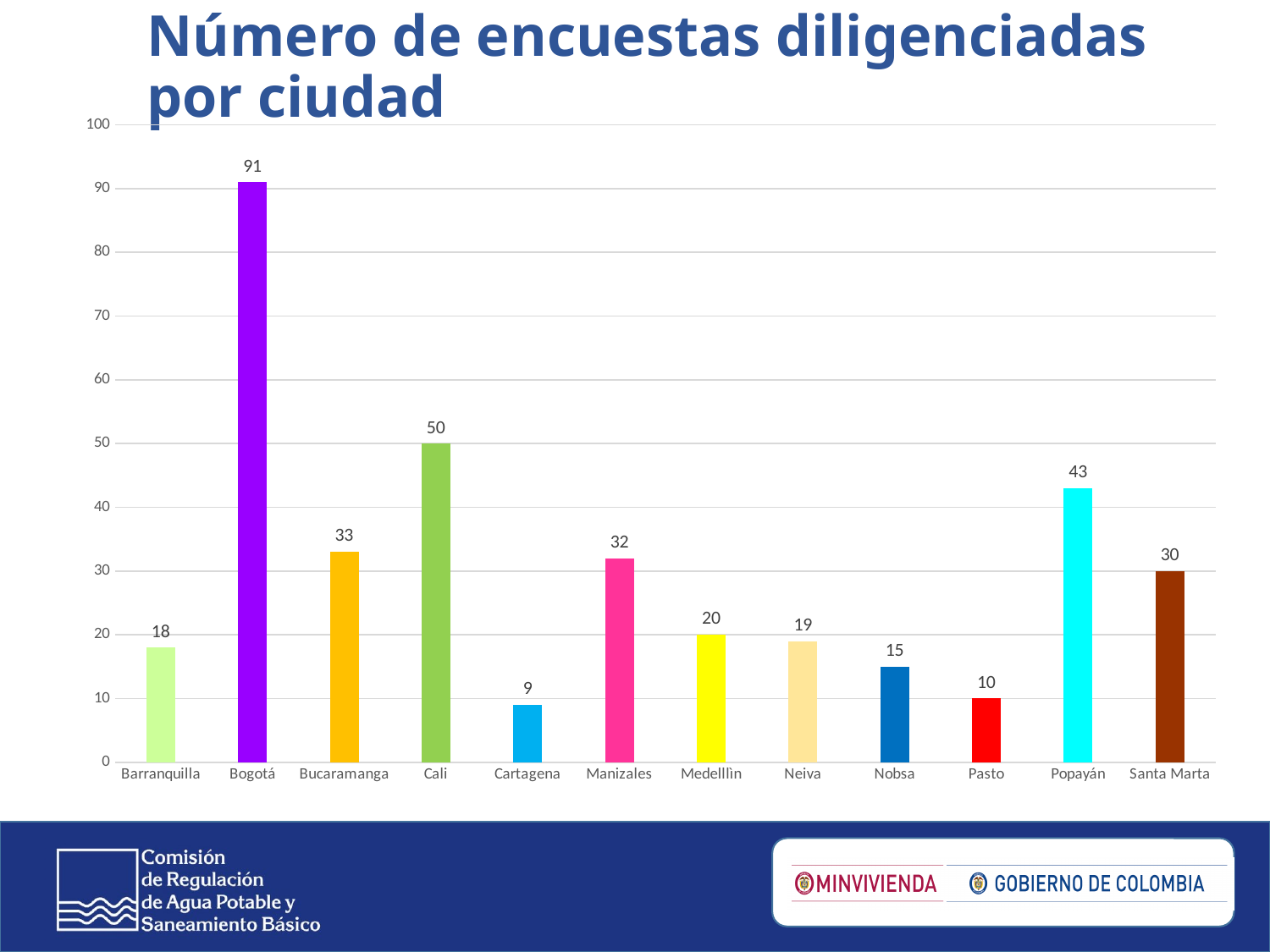
What is the value shown for Medellìn? 20 What is the difference between the values for Bucaramanga and Manizales? 1 Which city has the highest number of surveys? Bogotá How many surveys were completed in Bogotá? 91 Which city has the lowest number of surveys? Cartagena What kind of chart is shown on the slide? Bar chart How many cities are shown on the chart? 12 What is the title of the chart? Número de encuestas diligenciadas por ciudad Which has a larger value, Popayán or Santa Marta? Popayán Which has a larger value, Barranquilla or Nobsa? Barranquilla What is the difference between the values for Bogotá and Cali? 41 What is the value shown for Popayán? 43